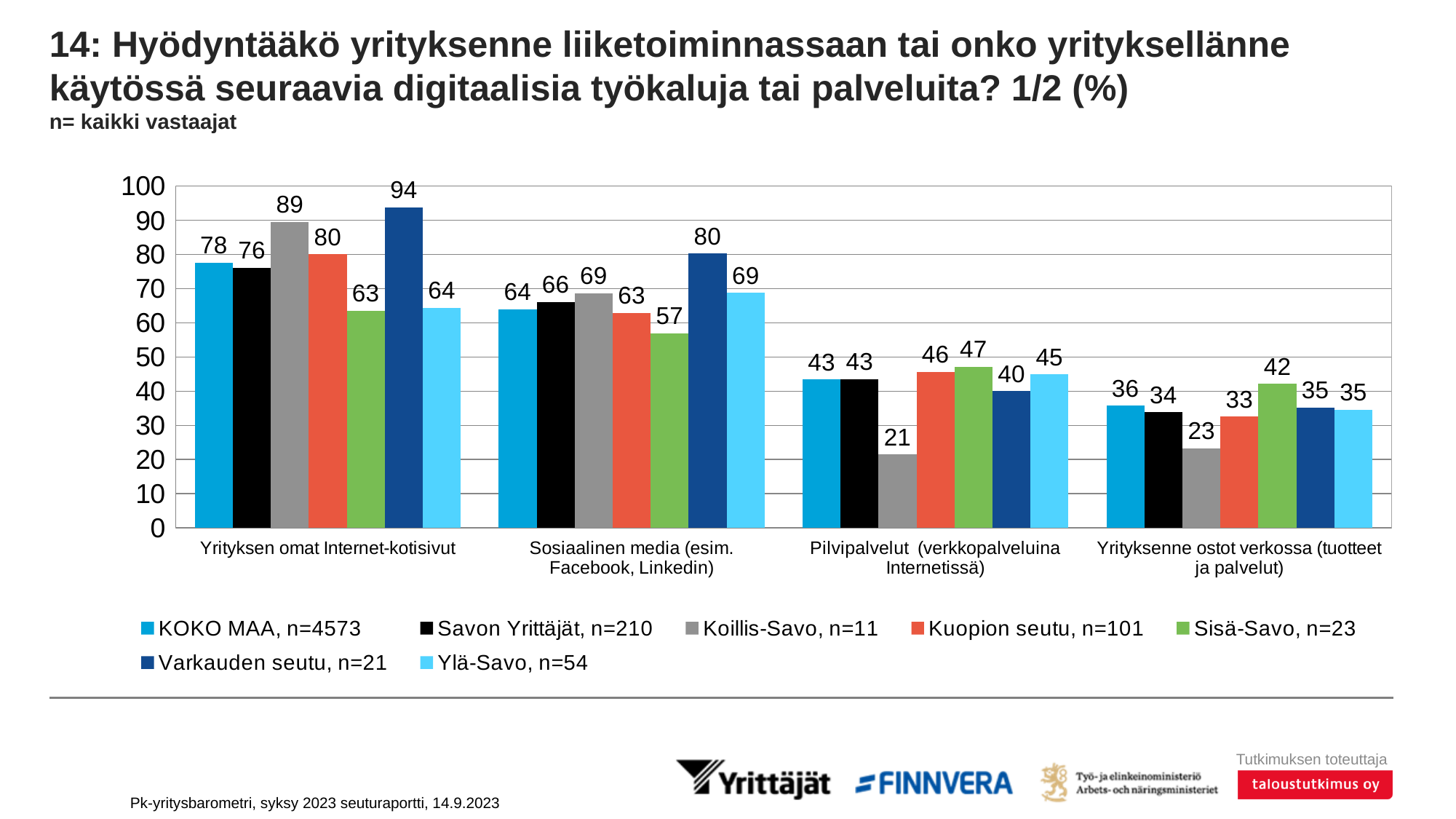
What is the difference between the Koillis-Savo and KOKO MAA values in the category Yrityksen omat Internet-kotisivut? 11 What is the value for Sisä-Savo in the category Yrityksenne ostot verkossa (tuotteet ja palvelut)? 42 Do the KOKO MAA values rise or fall across the categories from left to right? Fall How many series does the legend list? 7 What is the sample size (n) given in the legend for Savon Yrittäjät? 210 How many categories are shown on the x axis of the chart? 4 What is the value for Varkauden seutu in the category Yrityksen omat Internet-kotisivut? 94 In the category Pilvipalvelut (verkkopalveluina Internetissä), which is larger: the value for Kuopion seutu or the value for Varkauden seutu? Kuopion seutu What kind of chart is shown on the slide? Bar chart Which series has the lowest value in the category Yrityksen omat Internet-kotisivut? Sisä-Savo, n=23 What is the value for Koillis-Savo in the category Pilvipalvelut (verkkopalveluina Internetissä)? 21 Which series has the highest value in the category Sosiaalinen media (esim. Facebook, Linkedin)? Varkauden seutu, n=21